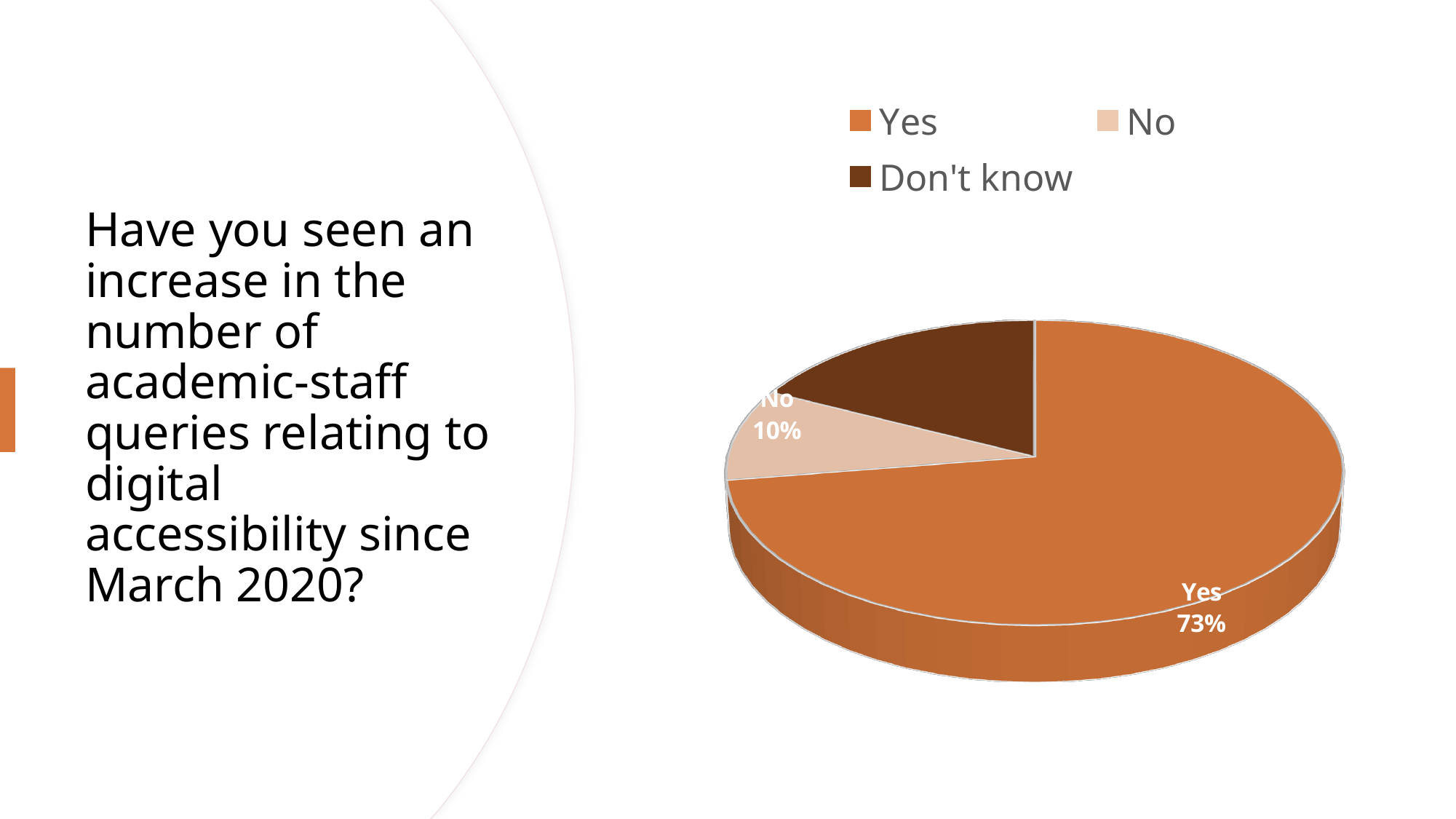
How many entries does the legend list? 3 Which response has the smallest share of the pie? No What percentage of respondents answered Yes? 73% Which legend entry is shown in the darkest brown colour? Don't know Which response has the largest share of the pie? Yes What kind of chart is shown on the slide? Pie chart What share of the pie does the Yes slice take up? 73% Which is larger, the Don't know slice or the No slice? Don't know What percentage of respondents answered No? 10% By how many percentage points does the Yes share exceed the No share? 63 percentage points How many response categories does the pie chart show? 3 Which is larger, the Yes slice or the Don't know slice? Yes